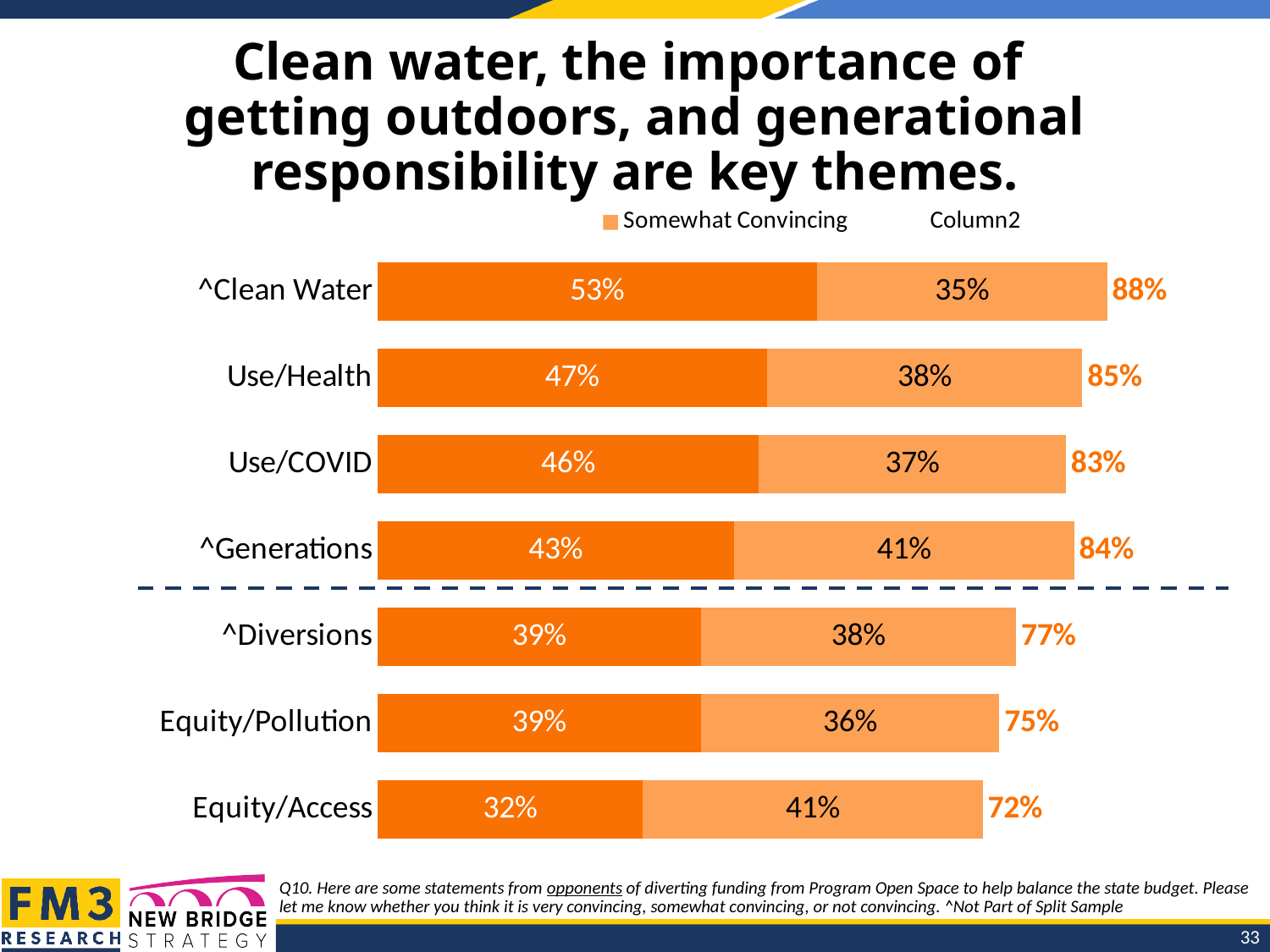
Which category has the highest total percentage? ^Clean Water Which category has the smallest darker orange (first) segment? Equity/Access Which category has the lowest total percentage? Equity/Access Which has the larger Somewhat Convincing value, Use/Health or Use/COVID? Use/Health What is the total percentage shown at the end of the ^Diversions bar? 77% What is the Somewhat Convincing value for ^Generations? 41% What kind of chart is shown on the slide? Stacked bar chart What is the Somewhat Convincing value for Equity/Pollution? 36% How many categories are shown in the chart? 7 What is the value of the darker orange (first) segment for Use/Health? 47% What is the total percentage shown for ^Generations? 84% What is the difference between the darker orange (first) segment for ^Clean Water and for Equity/Access? 21 percentage points